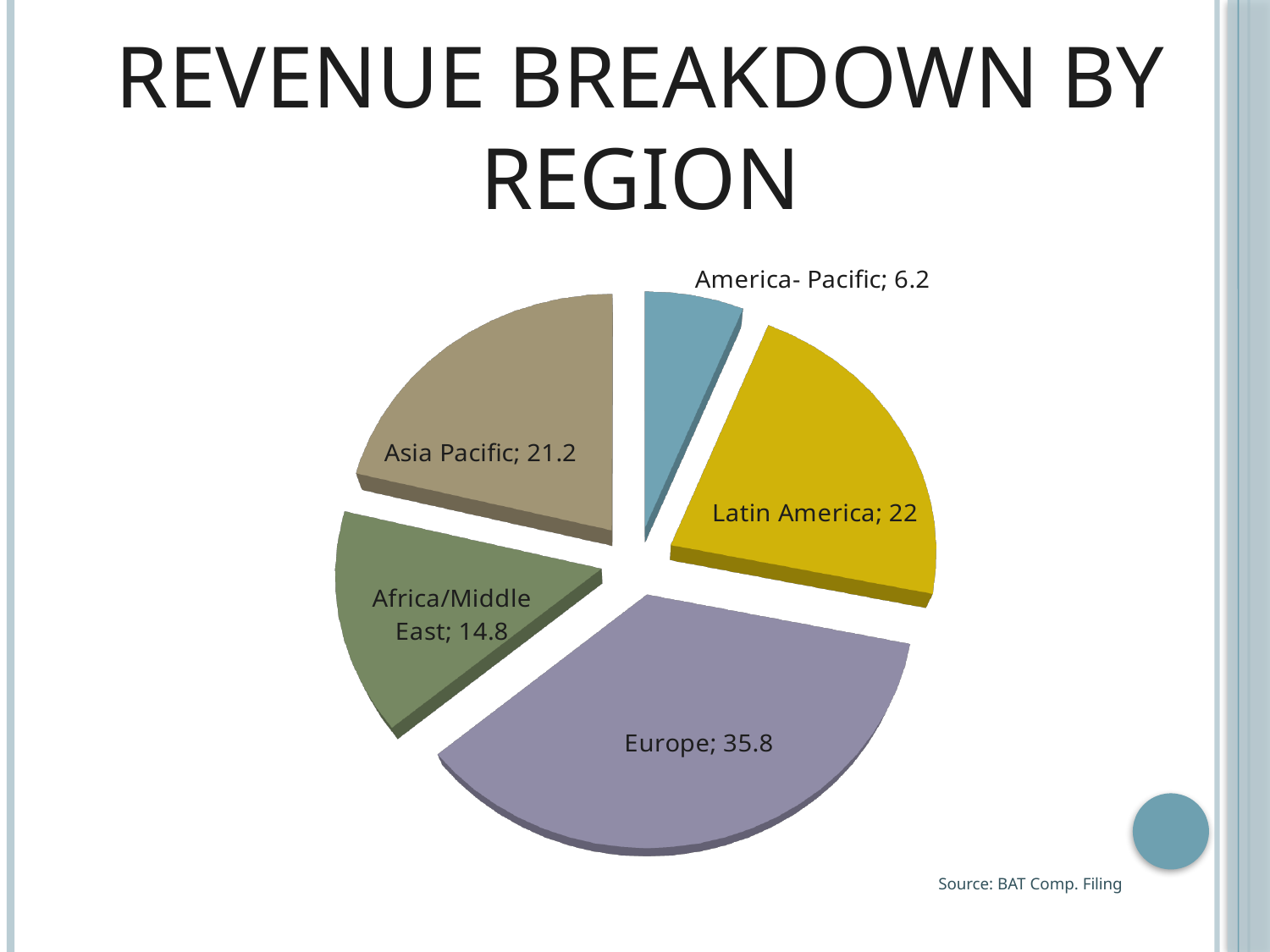
What is the value for America- Pacific? 6.2 What is the total of all the slice values in the pie chart? 100 Which region has the smallest slice? America- Pacific What is the value for Europe? 35.8 Which is larger, the value for Latin America or the value for Africa/Middle East? Latin America What kind of chart is shown on the slide? Pie chart What is the value for Africa/Middle East? 14.8 What is the value for Asia Pacific? 21.2 How many regions are shown in the pie chart? 5 What is the title of the chart? REVENUE BREAKDOWN BY REGION What is the difference between the values for Europe and Latin America? 13.8 Which region has the largest slice? Europe